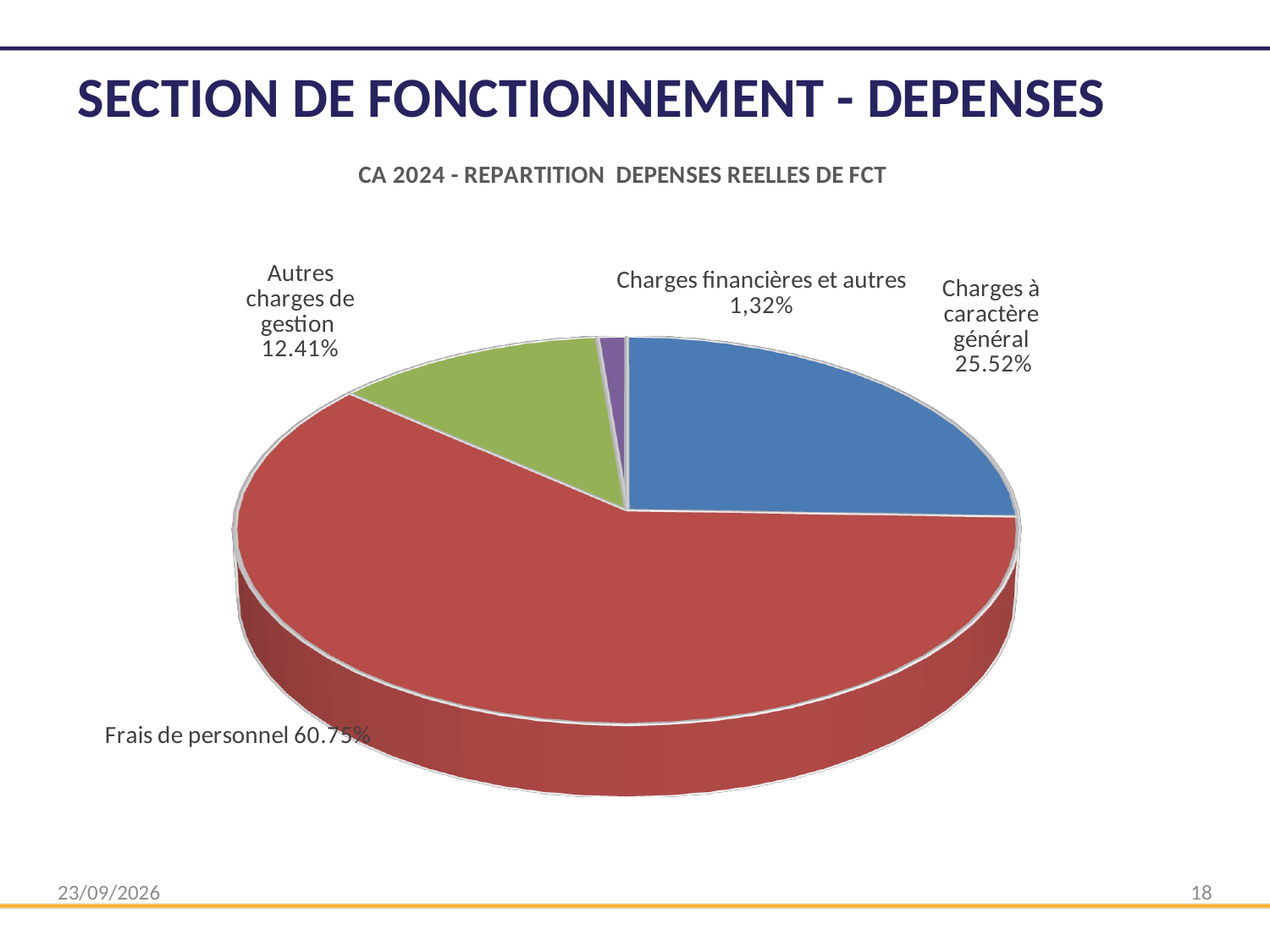
What share of the pie does Charges à caractère général represent? 25.52% What colour is the slice for Frais de personnel? Red What kind of chart is shown on the slide? Pie chart What is the difference in percentage points between Frais de personnel and Charges à caractère général? 35.23 How many slices does the pie chart have? 4 Which category has the largest slice of the pie? Frais de personnel What share of the pie does Autres charges de gestion represent? 12.41% Which is larger: Charges à caractère général or Autres charges de gestion? Charges à caractère général What share of the pie does Frais de personnel represent? 60.75% Which category has the smallest slice of the pie? Charges financières et autres What share of the pie does Charges financières et autres represent? 1,32% What is the title of the chart? CA 2024 - REPARTITION DEPENSES REELLES DE FCT